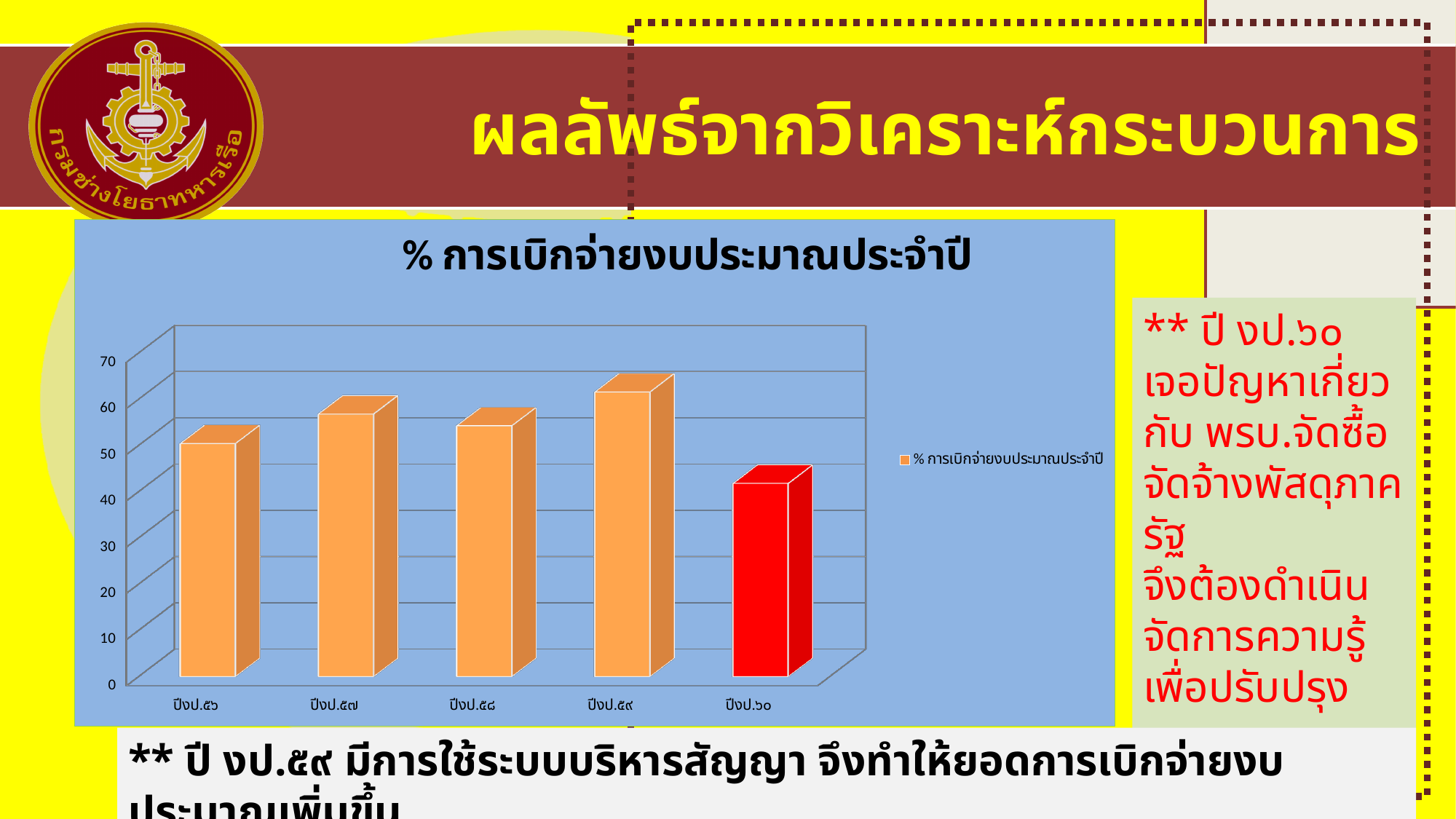
What kind of chart is shown on the slide? bar chart Is the value for ปีงป.๕๖ greater or less than 40? greater What is the title of the chart? % การเบิกจ่ายงบประมาณประจำปี Is the value for ปีงป.๕๙ greater or less than 50? greater Which is larger, the value for ปีงป.๕๖ or the value for ปีงป.๕๗? ปีงป.๕๗ Which is larger, the value for ปีงป.๕๙ or the value for ปีงป.๖๐? ปีงป.๕๙ How many series does the chart legend list? 1 What colour is the bar for ปีงป.๖๐? red Which fiscal year has the highest value on the chart? ปีงป.๕๙ Is the value for ปีงป.๖๐ greater or less than 50? less How many categories (fiscal years) are plotted on the chart? 5 Which fiscal year has the lowest value on the chart? ปีงป.๖๐